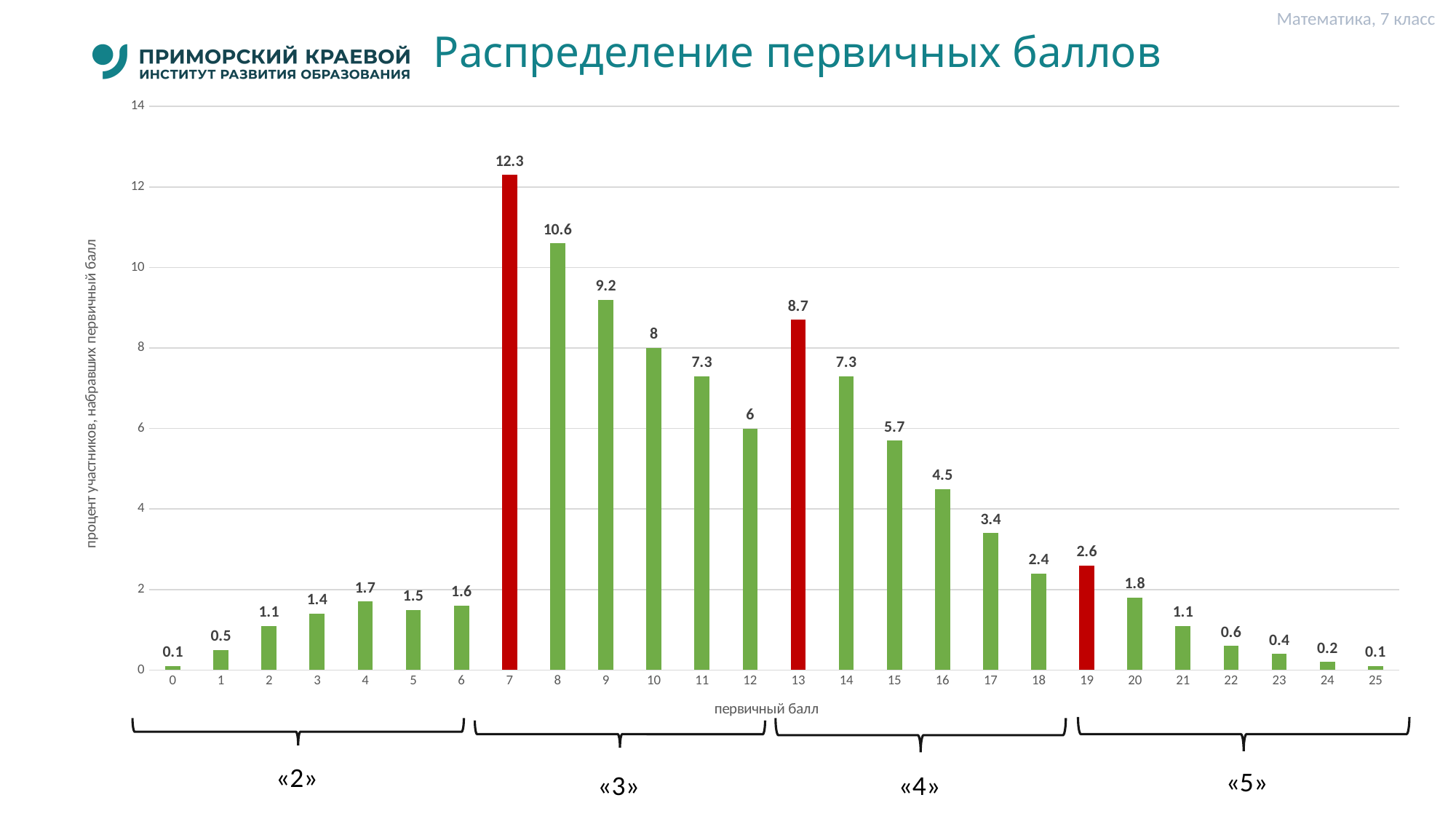
How many primary score categories are shown on the x axis? 26 What colour are the bars for primary scores 7, 13 and 19? red What is the percentage of participants who scored 7 primary points? 12.3 What is the difference between the values for primary scores 7 and 8? 1.7 Which primary score has the highest percentage of participants? 7 What is the value for primary score 19? 2.6 Do the values rise or fall along the x axis from primary score 7 to primary score 12? fall What type of chart is shown on the slide? bar chart Which is larger, the value for primary score 10 or for primary score 14? primary score 10 Is the value for primary score 12 greater or less than 4? greater What is the value for primary score 13? 8.7 What is the value for primary score 4? 1.7